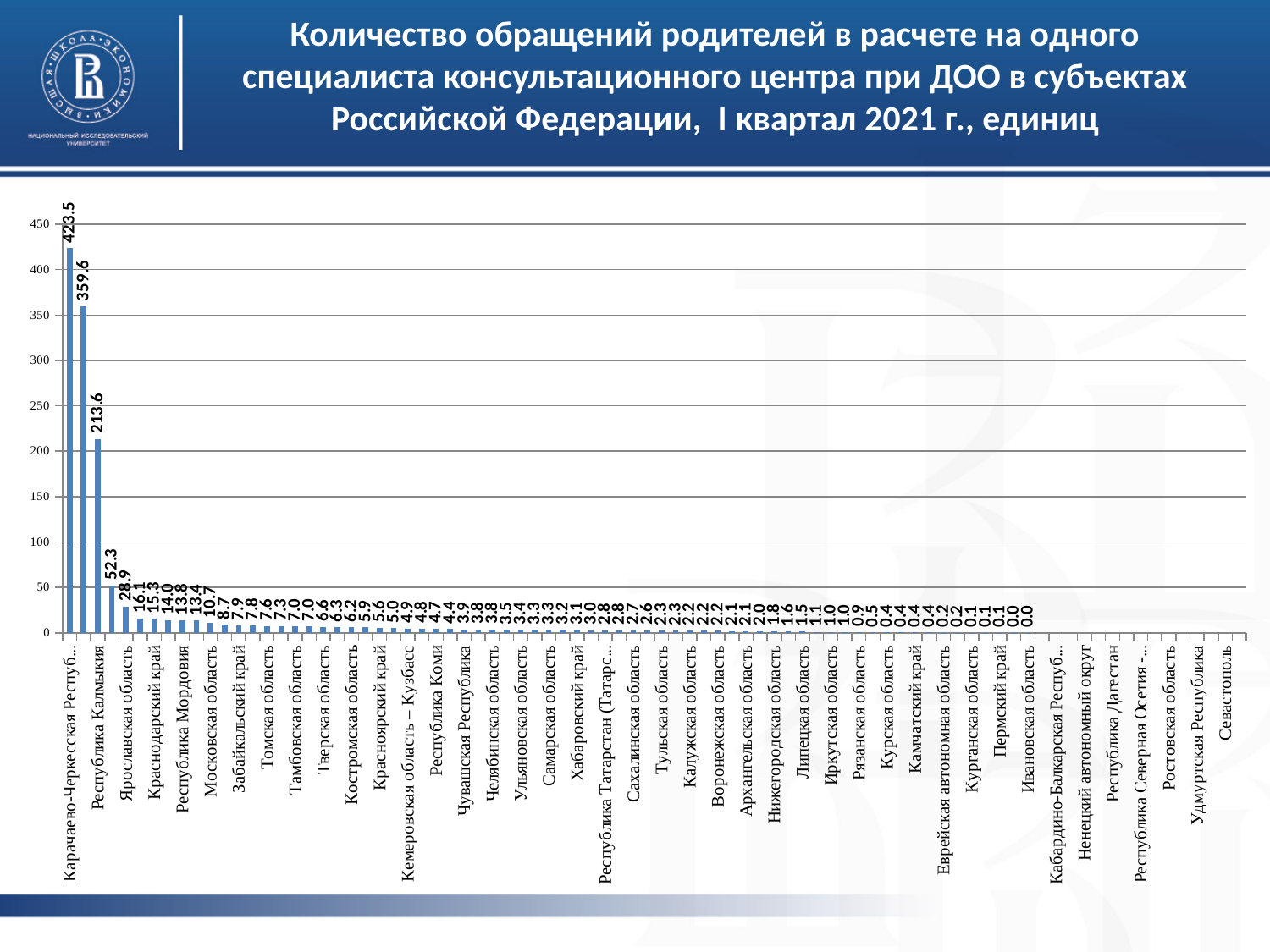
Which is larger, the value for Карачаево-Черкесская Республика or the value for Республика Калмыкия? Карачаево-Черкесская Республика Which region has the highest number of parent requests per specialist? Карачаево-Черкесская Республика Is the value for Ярославская область greater or less than 100? less What kind of chart is shown on the slide? bar chart What is the lowest value printed as a data label on the chart? 0.0 What is the highest tick value shown on the vertical axis? 450 What is the difference between the highest value (423.5) and the second-highest value (359.6)? 63.9 Is the value for Краснодарский край greater or less than 50? less For which period does the chart title say the data is given? I квартал 2021 г. What is the second-highest value printed on the chart? 359.6 Is the value for Республика Калмыкия greater or less than 200? greater What is the value for Карачаево-Черкесская Республика? 423.5